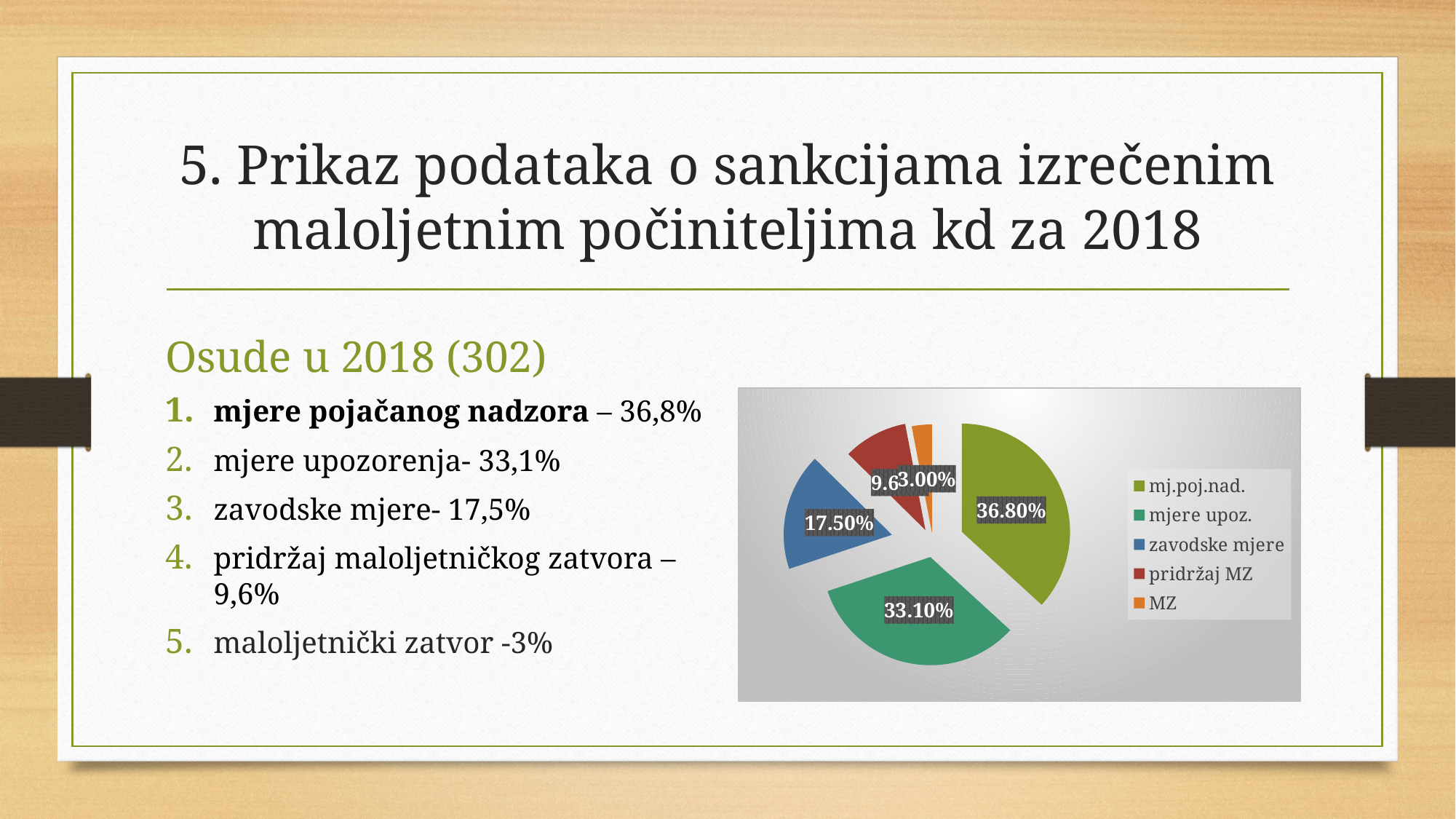
Which category has the largest slice in the pie chart? mj.poj.nad. Which slice is larger, zavodske mjere or mjere upoz.? mjere upoz. What is the difference between the mjere upoz. and zavodske mjere slices? 15.60% Which slice is larger, pridržaj MZ or MZ? pridržaj MZ What is the difference between the mj.poj.nad. and mjere upoz. slices? 3.70% What kind of chart is shown on the slide? pie chart How many categories does the legend of the pie chart list? 5 Which category has the smallest slice in the pie chart? MZ What percentage does the pie chart show for mjere upoz.? 33.10% What percentage does the pie chart show for zavodske mjere? 17.50% What colour is the mj.poj.nad. slice in the pie chart? green What percentage does the pie chart show for mj.poj.nad.? 36.80%